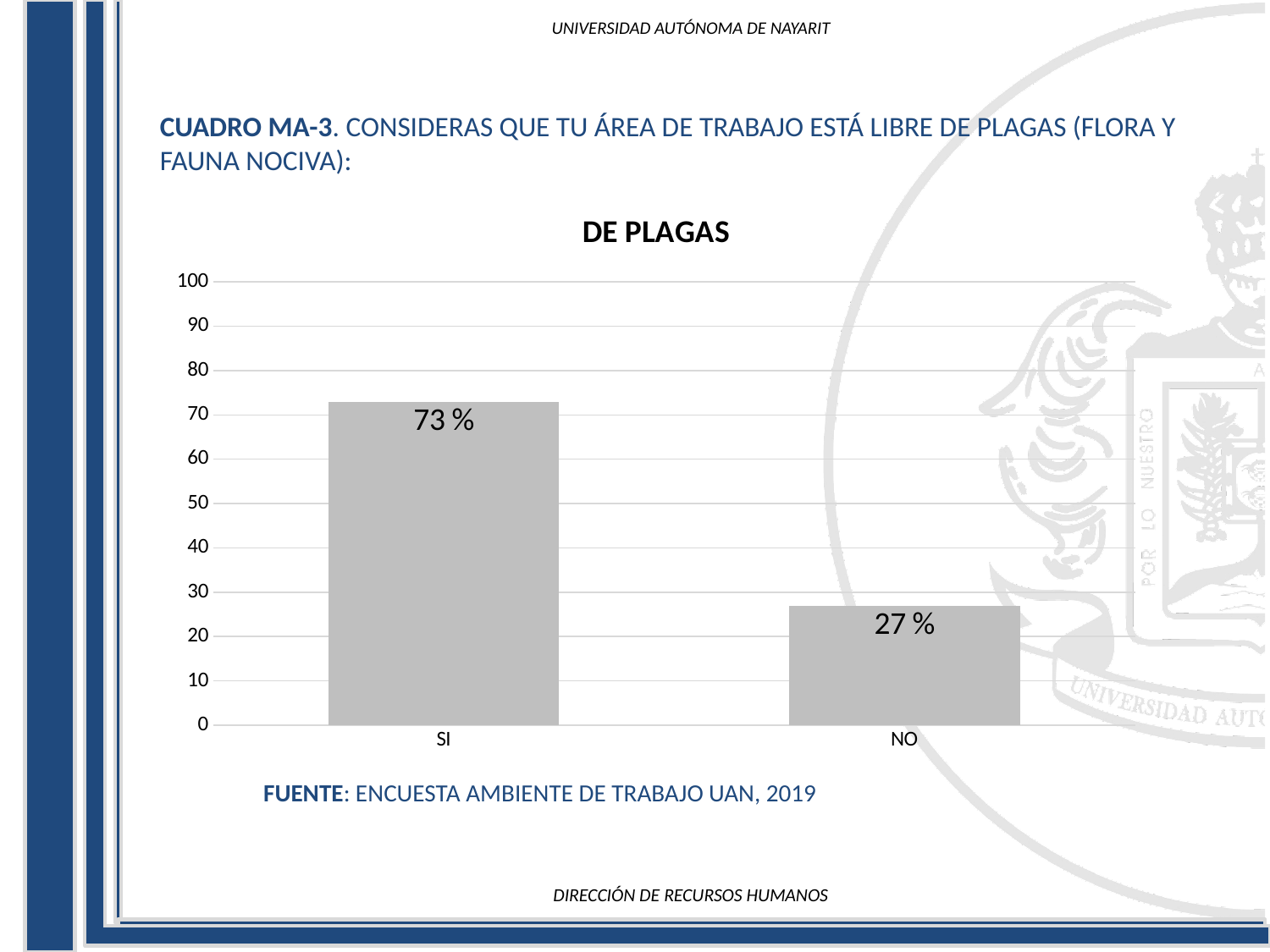
What is the value for SI? 73 % What is the title of the chart? DE PLAGAS What is the maximum value shown on the y axis? 100 Which category has the lowest value? NO What is the value for NO? 27 % How many categories are shown on the x axis? 2 Which category has the highest value? SI Which is larger, the value for SI or the value for NO? SI What is the difference between the values for SI and NO? 46 % Is the value for SI greater or less than 50? greater Is the value for NO greater or less than 30? less What kind of chart is shown? bar chart